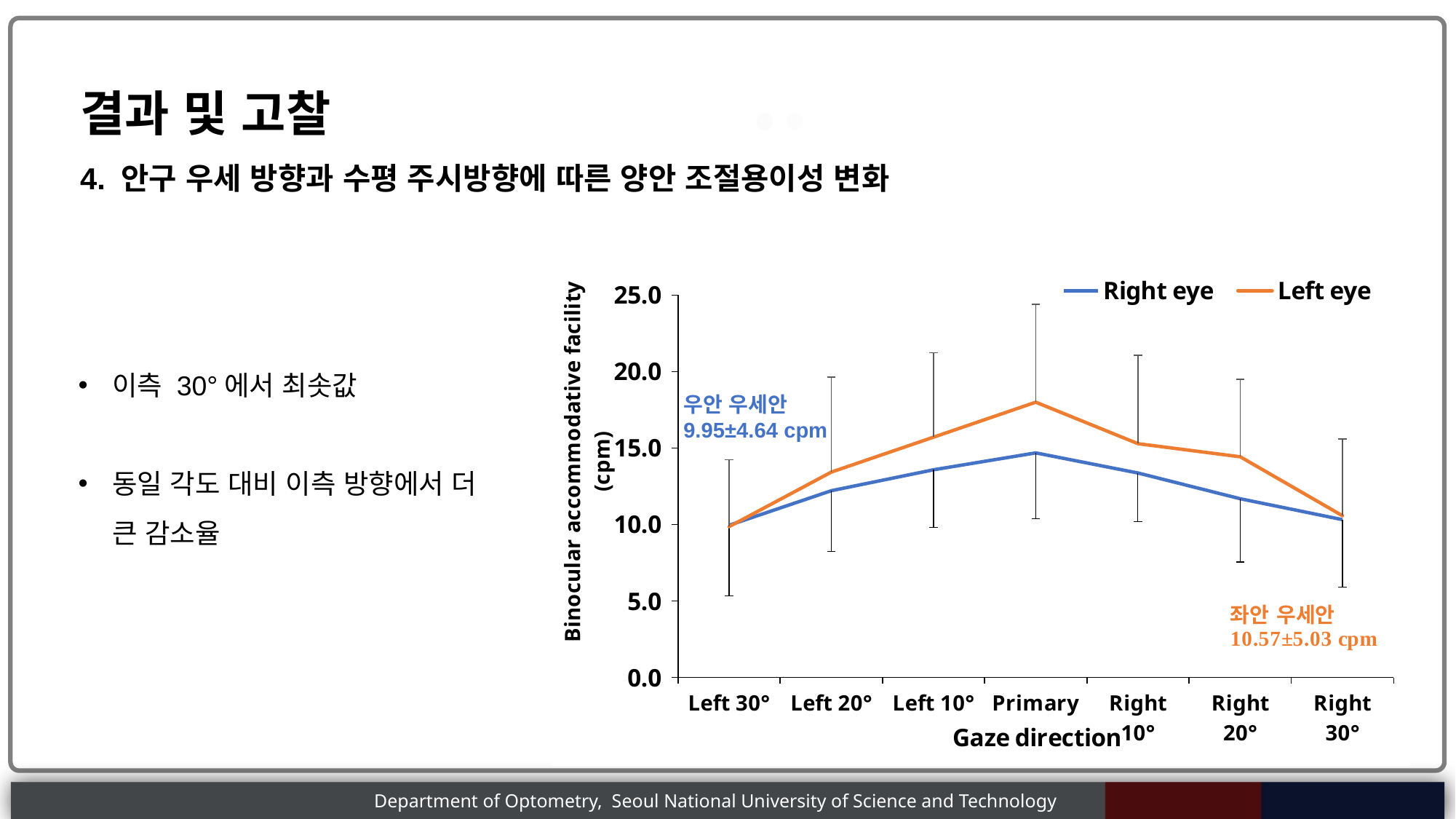
Is the Left eye value at Primary greater or less than 15.0? greater At the Primary gaze direction, which series has the larger value, Right eye or Left eye? Left eye Does the Right eye series rise or fall from Left 30° to Primary? rise How many series does the chart legend list? 2 What value is annotated on the chart for 좌안 우세안? 10.57±5.03 cpm At which gaze direction does the Right eye series reach its highest value? Primary At which gaze direction does the Left eye series reach its highest value? Primary How many gaze direction categories are plotted on the x axis? 7 Does the Left eye series rise or fall from Primary to Right 30°? fall What value is annotated on the chart for 우안 우세안? 9.95±4.64 cpm What kind of chart is shown on the slide? line chart Is the Right eye value at Left 20° greater or less than 10.0? greater